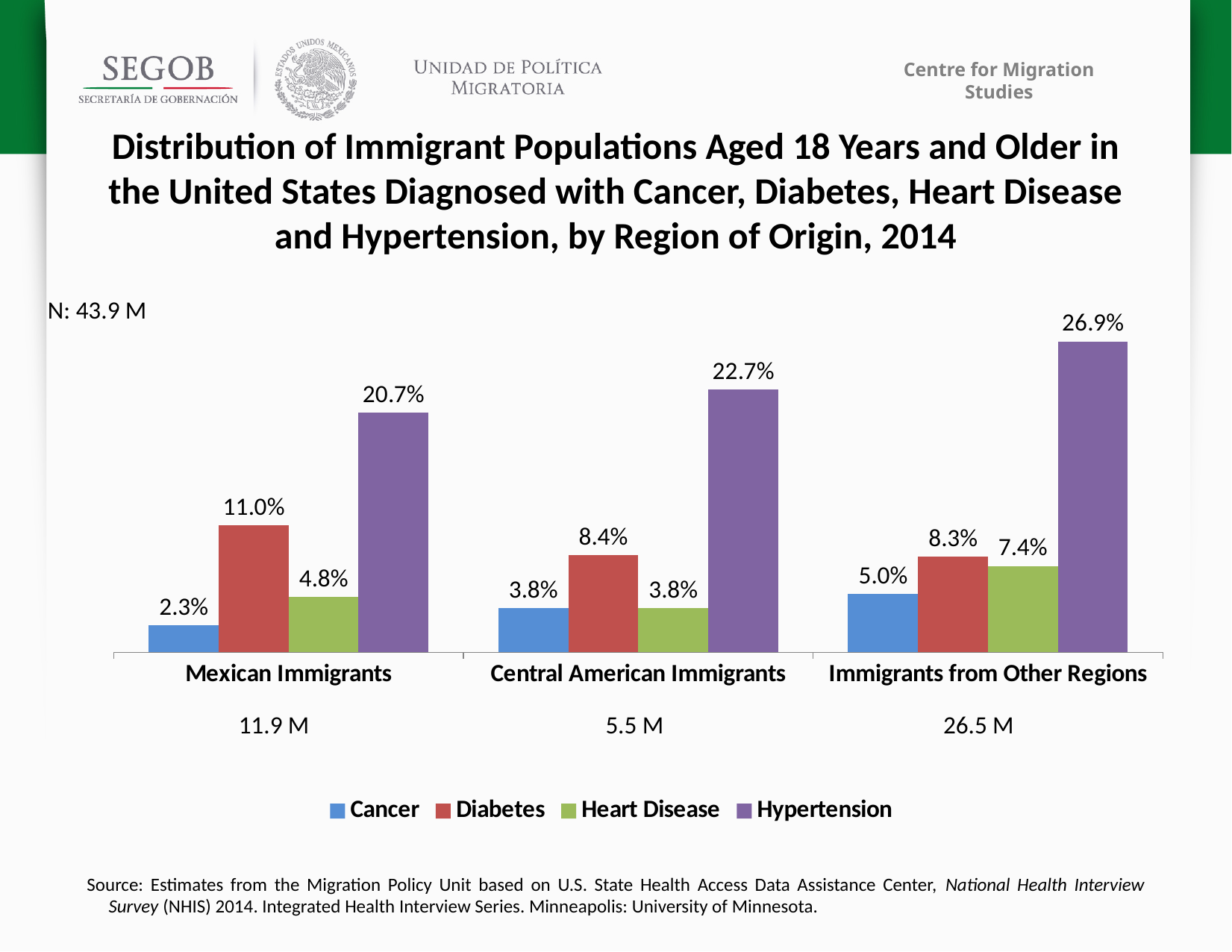
Which region has the lowest Cancer value? Mexican Immigrants What is the Cancer value for Immigrants from Other Regions? 5.0% What is the difference between the Hypertension values for Immigrants from Other Regions and Mexican Immigrants? 6.2% What kind of chart is shown on the slide? Bar chart Which is larger, the Diabetes value for Mexican Immigrants or the Diabetes value for Central American Immigrants? Mexican Immigrants What is the Hypertension value for Mexican Immigrants? 20.7% What is the population figure shown below Central American Immigrants? 5.5 M Which colour represents Heart Disease in the legend? Green Which region has the highest Hypertension value? Immigrants from Other Regions What is the Diabetes value for Central American Immigrants? 8.4% How many series does the legend list? 4 How many regions of origin are shown on the x axis? 3